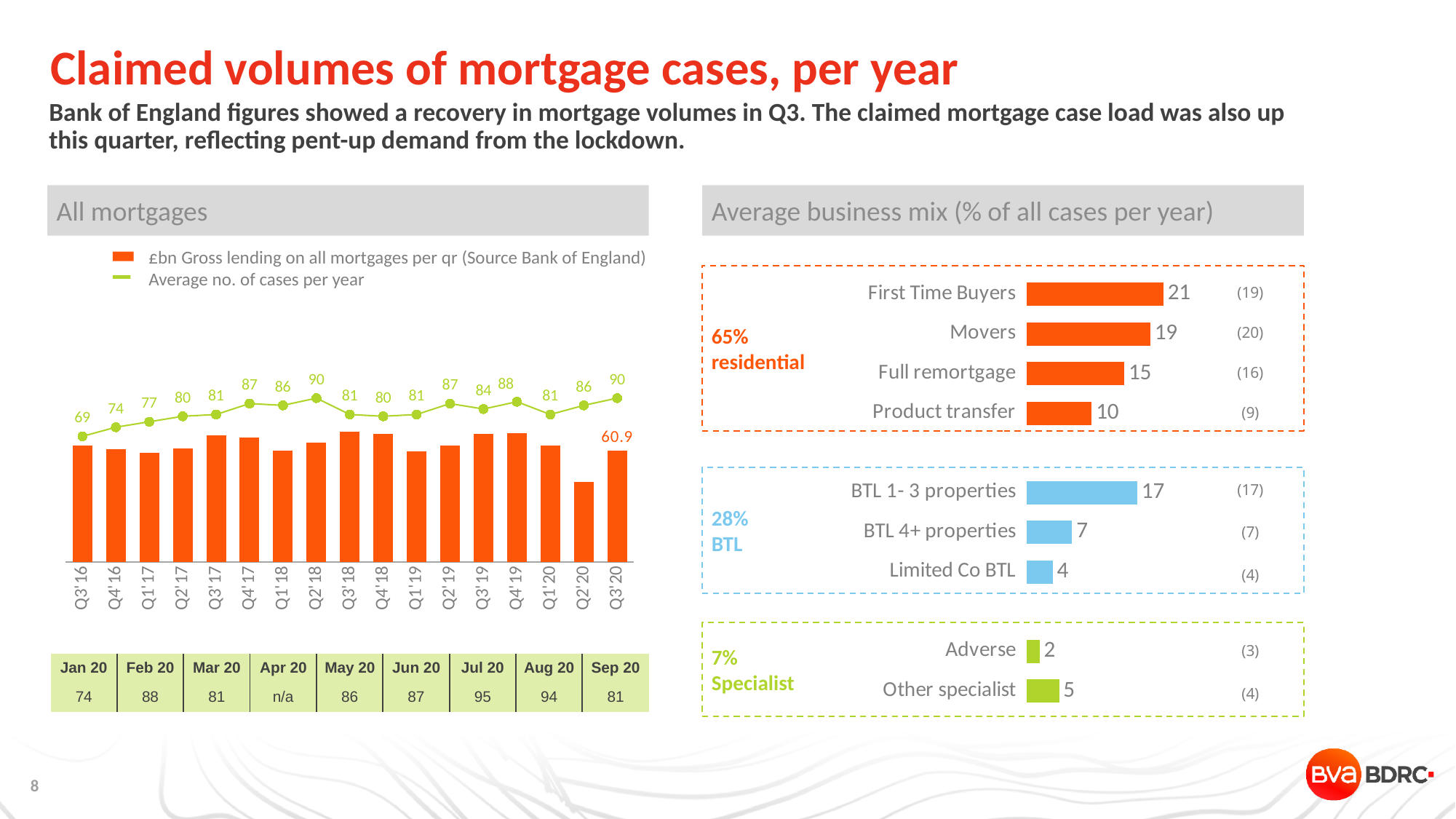
In the Average business mix chart, which category has the highest value? First Time Buyers In the Average business mix chart, what is the value for First Time Buyers? 21 In the All mortgages chart, what is the difference between the average number of cases per year in Q3'20 and in Q3'16? 21 How many categories are plotted in the Average business mix chart? 9 In the Average business mix chart, what is the difference between First Time Buyers and Movers? 2 In the Average business mix chart, which category has the lowest value? Adverse In the All mortgages chart, how many quarters are shown on the x axis? 17 In the Average business mix chart, which is larger: BTL 1- 3 properties or Full remortgage? BTL 1- 3 properties In the All mortgages chart, what is the £bn gross lending value labelled for Q3'20? 60.9 In the All mortgages chart, which quarter has the lowest gross lending bar? Q2'20 How many series does the legend of the All mortgages chart list? 2 In the All mortgages chart, what is the average number of cases per year shown for Q2'18? 90